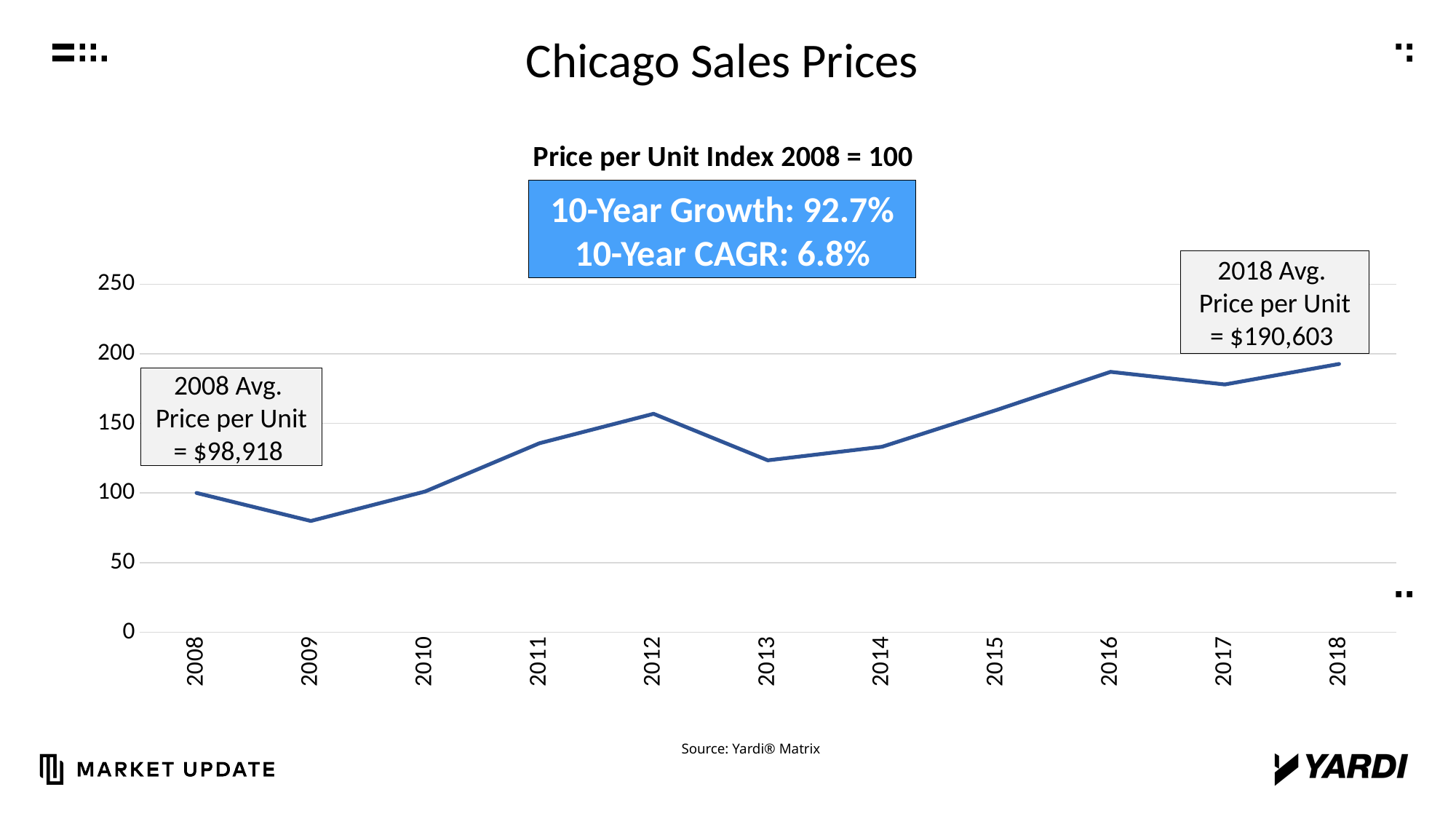
Is the Price per Unit Index value for 2012 greater or less than 150? greater How many years are plotted on the x axis of the chart? 11 Which year has the highest Price per Unit Index value? 2018 Is the Price per Unit Index value for 2013 greater or less than 150? less Which year has the lowest Price per Unit Index value? 2009 Is the Price per Unit Index value for 2009 greater or less than 100? less Which year has the larger Price per Unit Index value, 2012 or 2013? 2012 What kind of chart is shown on the slide? line chart Does the Price per Unit Index generally rise or fall from 2008 to 2018? rise What is the Price per Unit Index value for 2008? 100 According to the annotation on the chart, what was the 2018 average price per unit? $190,603